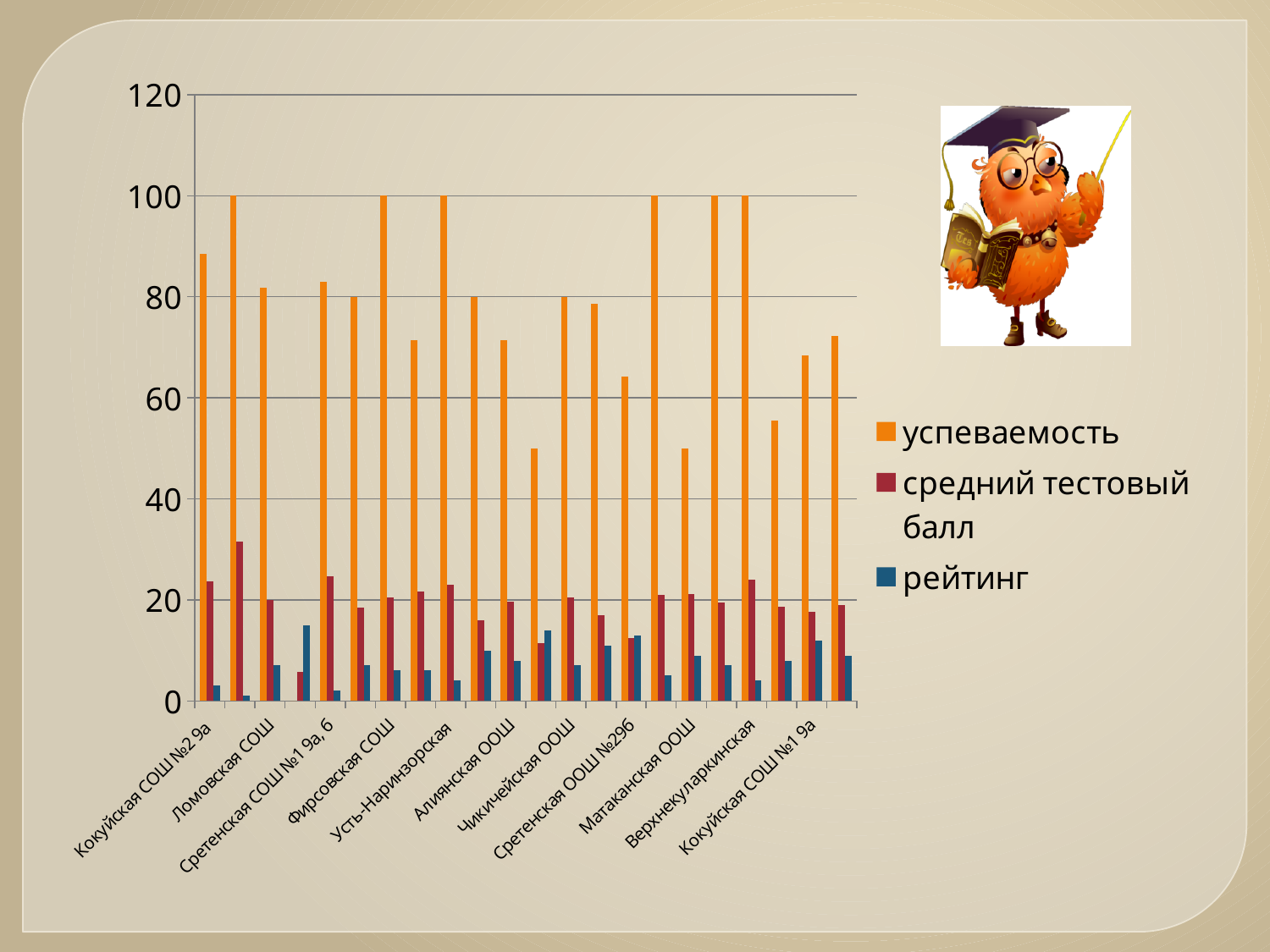
Which has the larger успеваемость value, Кокуйская СОШ №2 9а or Матаканская ООШ? Кокуйская СОШ №2 9а What is the highest value shown on the vertical axis? 120 Which has the larger успеваемость value, Усть-Наринзорская or Сретенская ООШ №296? Усть-Наринзорская Which series is shown in orange? успеваемость Is the успеваемость value for Матаканская ООШ greater or less than 60? less How many series does the legend list? 3 Is the рейтинг value for Ломовская СОШ greater or less than 20? less Which series is shown in blue? рейтинг Is the средний тестовый балл value for Кокуйская СОШ №2 9а greater or less than 40? less What kind of chart is shown on the slide? bar chart